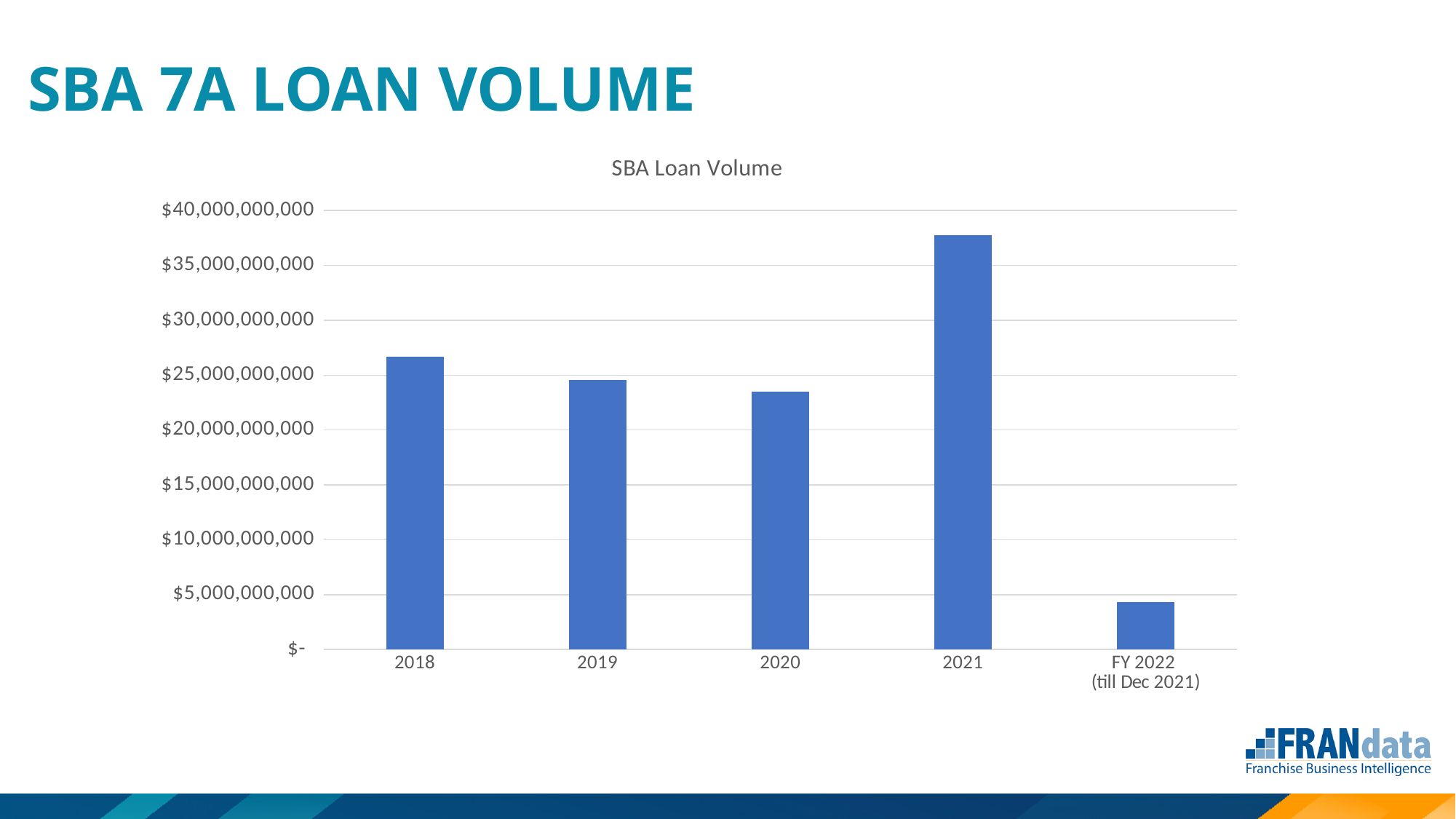
Which is larger, the loan volume for 2018 or for 2019? 2018 What type of chart is shown on the slide? Bar chart Is the value for 2018 greater or less than $25,000,000,000? greater What is the title of the chart? SBA Loan Volume Is the value for 2021 greater or less than $35,000,000,000? greater Is the value for FY 2022 (till Dec 2021) greater or less than $5,000,000,000? less Which year has the highest SBA loan volume? 2021 How many bars (categories) are shown in the chart? 5 Which is larger, the loan volume for 2021 or for 2018? 2021 Which category has the lowest SBA loan volume? FY 2022 (till Dec 2021) Do the values rise or fall from 2018 to 2020? fall